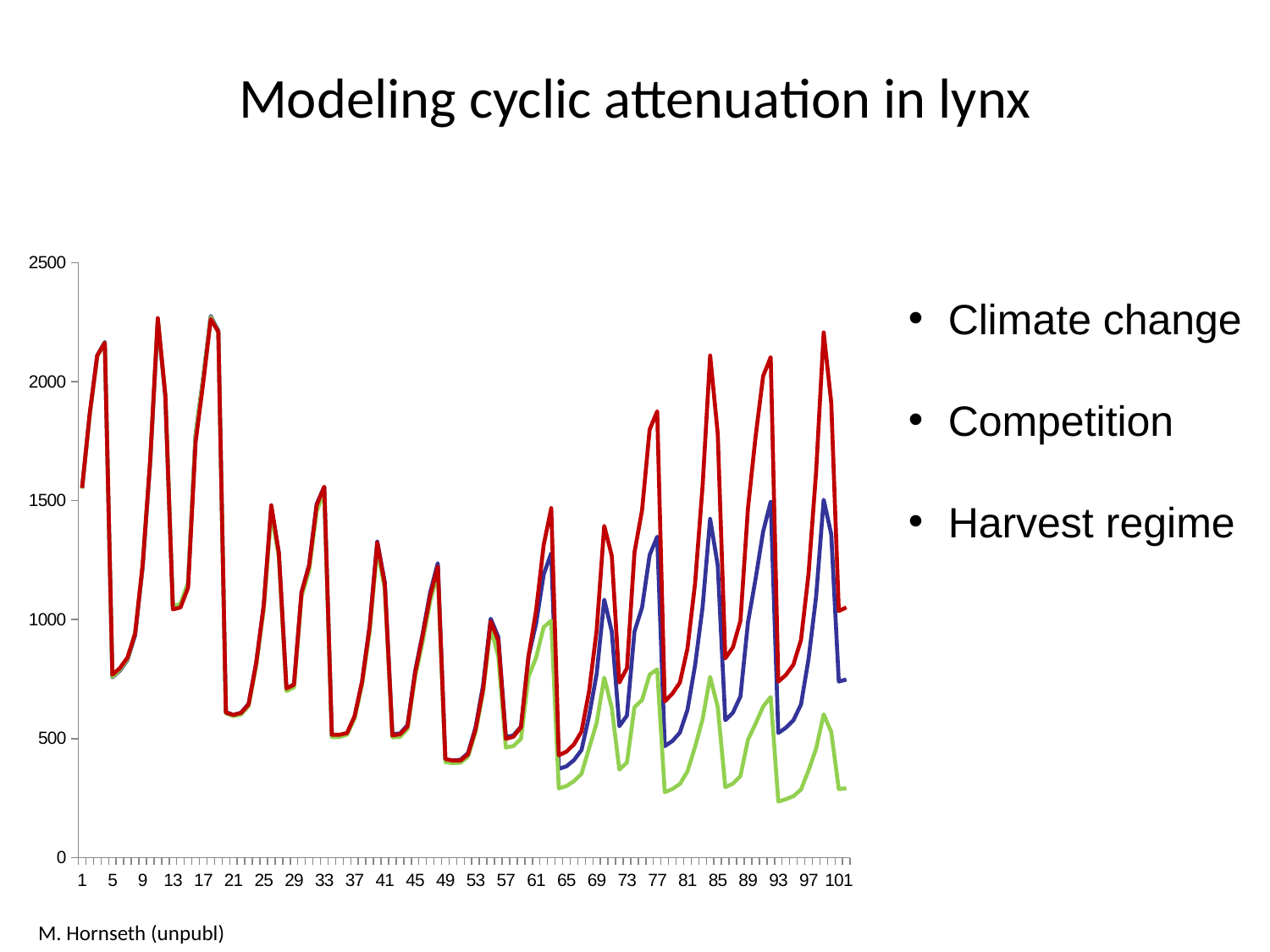
Do the peaks of the green line rise or fall from x = 65 to x = 101? fall Is the peak of the red line near x = 9 greater or less than 2000? greater Is the peak of the red line near x = 85 greater or less than 2000? greater At x = 101, which line has the larger value, the red line or the green line? red line What kind of chart is shown on the slide? line chart What is the last tick label on the chart's x axis? 101 How many lines (series) are plotted on the chart? 3 What is the highest value shown on the chart's y axis? 2500 Is the value of the green line at x = 101 greater or less than 500? less What is the title of the slide containing the chart? Modeling cyclic attenuation in lynx